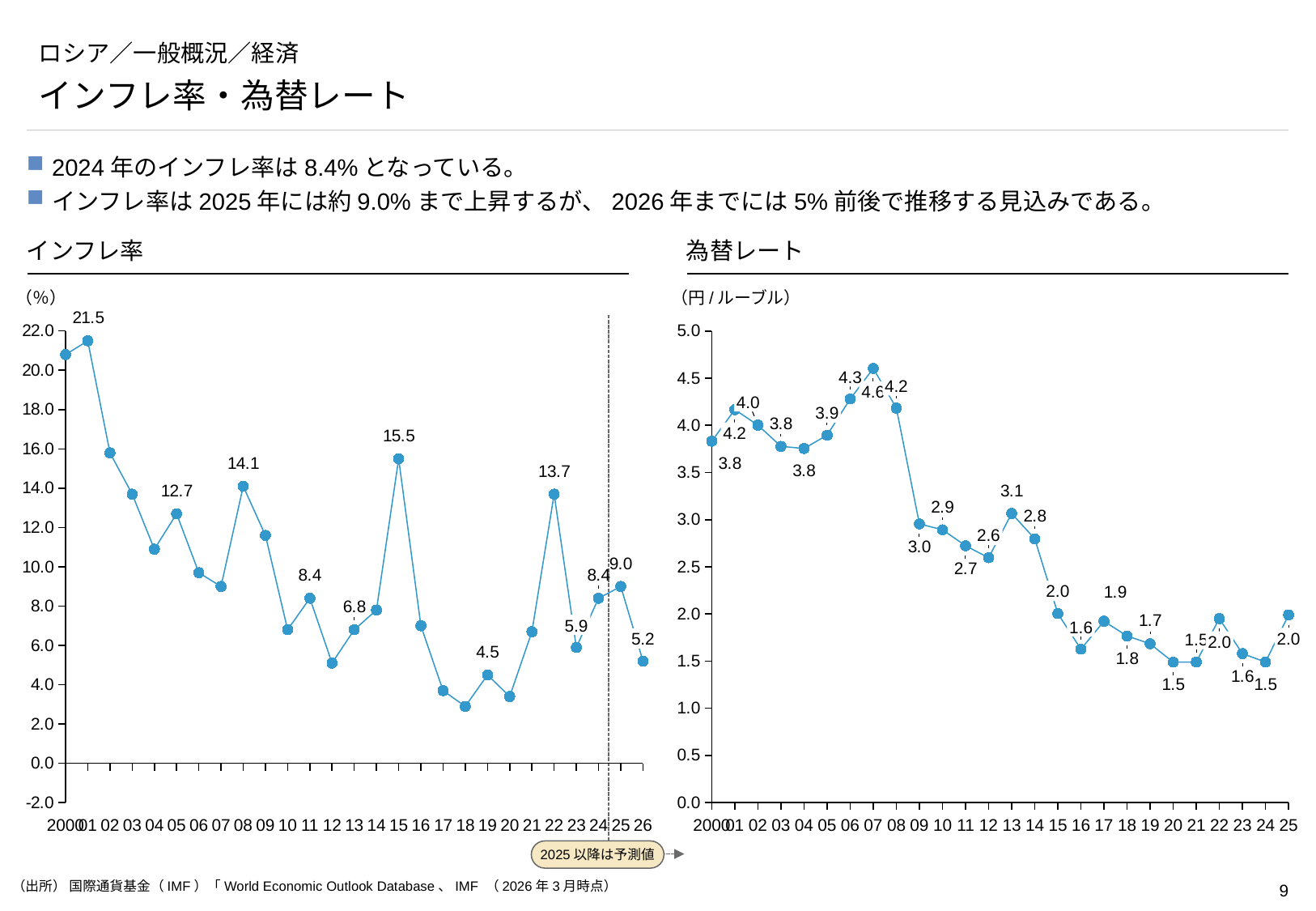
On the 為替レート chart, which year has the highest value? 2007 On the インフレ率 chart, which year has the highest inflation rate? 2001 What unit is shown on the 為替レート chart? 円/ルーブル On the インフレ率 chart, what is the inflation rate for 2015? 15.5 On the 為替レート chart, do the values generally rise or fall from 2000 to 2025? fall On the インフレ率 chart, what is the inflation rate for 2024? 8.4 On the インフレ率 chart, what is the difference between the 2025 and 2026 values? 3.8 On the インフレ率 chart, is the value for 2018 greater or less than 4.0? less On the インフレ率 chart, which is larger, the value for 2008 or the value for 2022? 2008 What kind of chart is the 為替レート chart? line chart On the 為替レート chart, what is the value for 2013? 3.1 On the 為替レート chart, what is the value for 2007? 4.6